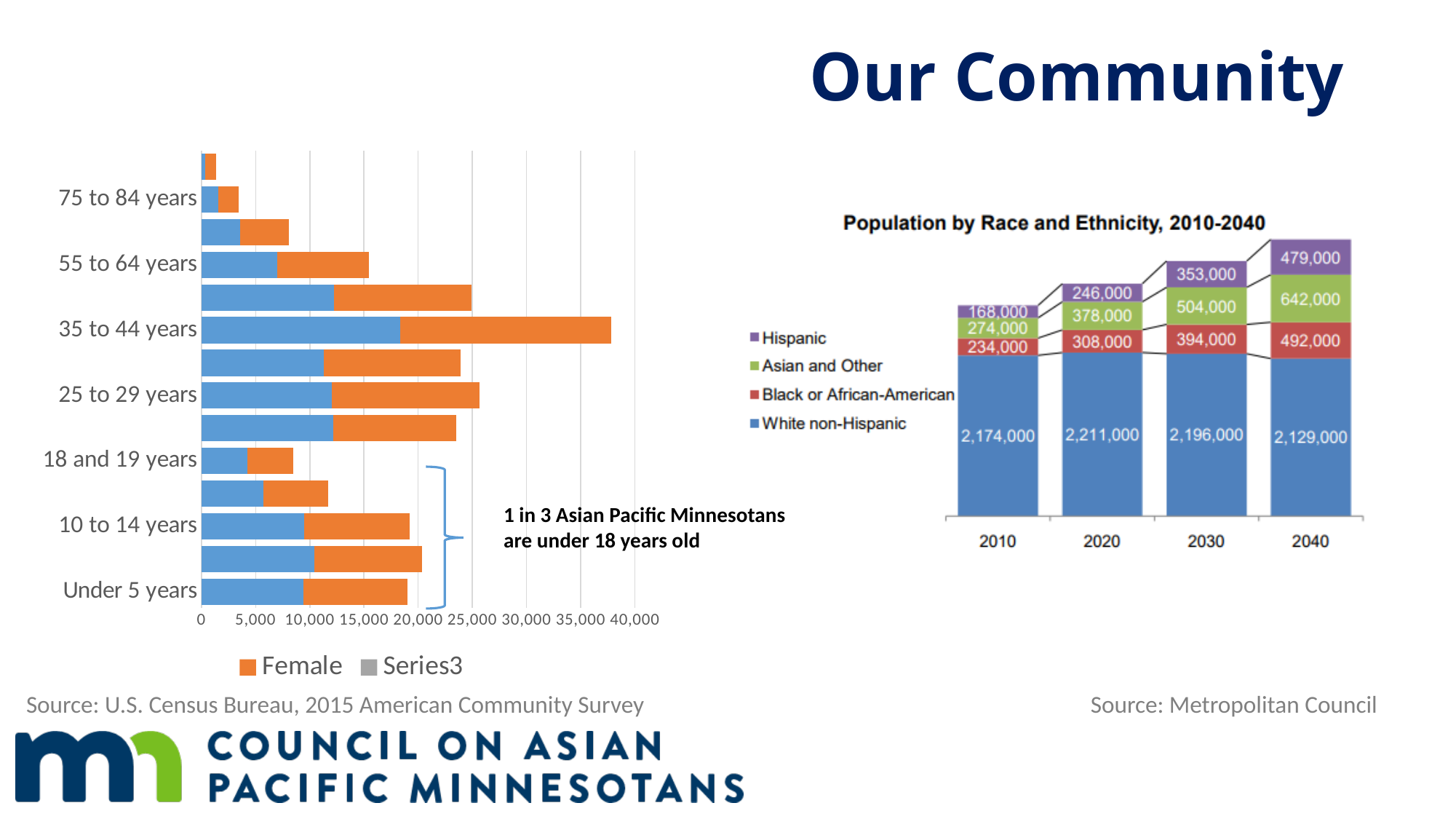
In the 'Population by Race and Ethnicity, 2010-2040' chart, what is the White non-Hispanic value for 2020? 2,211,000 What kind of chart is the age-group chart on the left of the slide? bar chart In the 'Population by Race and Ethnicity, 2010-2040' chart, what is the Asian and Other value for 2010? 274,000 In the 'Population by Race and Ethnicity, 2010-2040' chart, what is the total population shown for 2010 across all four groups? 2,850,000 In the 'Population by Race and Ethnicity, 2010-2040' chart, by how much does the Asian and Other value increase from 2010 to 2040? 368,000 In the 'Population by Race and Ethnicity, 2010-2040' chart, does the Hispanic value rise or fall from 2010 to 2040? rise In the 'Population by Race and Ethnicity, 2010-2040' chart, what is the Hispanic population value for 2040? 479,000 In the age-group chart on the left, is the total bar length for '35 to 44 years' greater or less than 35,000? greater In the 'Population by Race and Ethnicity, 2010-2040' chart, is the Black or African-American value for 2030 larger or smaller than the Hispanic value for 2030? larger How many series does the legend of the 'Population by Race and Ethnicity, 2010-2040' chart list? 4 In the age-group chart on the left, is the total bar length for '18 and 19 years' greater or less than 10,000? less In the 'Population by Race and Ethnicity, 2010-2040' chart, which year has the highest White non-Hispanic value? 2020